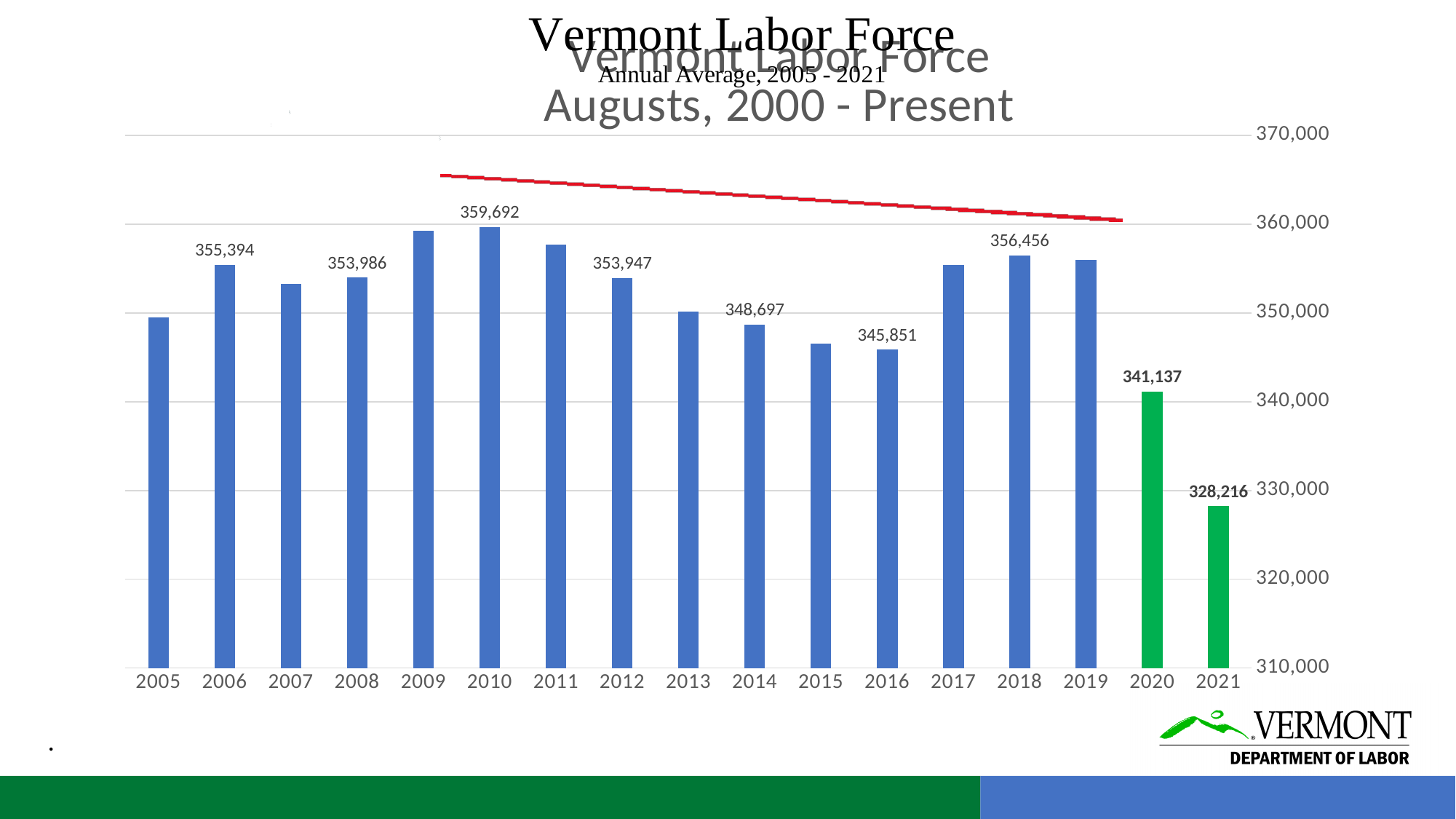
What is the value for 2021? 328,216 Which is larger, the value for 2006 or the value for 2008? 2006 How many years are shown on the x axis? 17 What kind of chart is this? bar chart What is the value for 2020? 341,137 Which year has the lowest value? 2021 What is the difference between the values for 2020 and 2021? 12,921 What is the value for 2010? 359,692 What is the difference between the values for 2018 and 2020? 15,319 Is the value for 2015 greater or less than 350,000? less Is the value for 2011 greater or less than 350,000? greater What is the value for 2016? 345,851